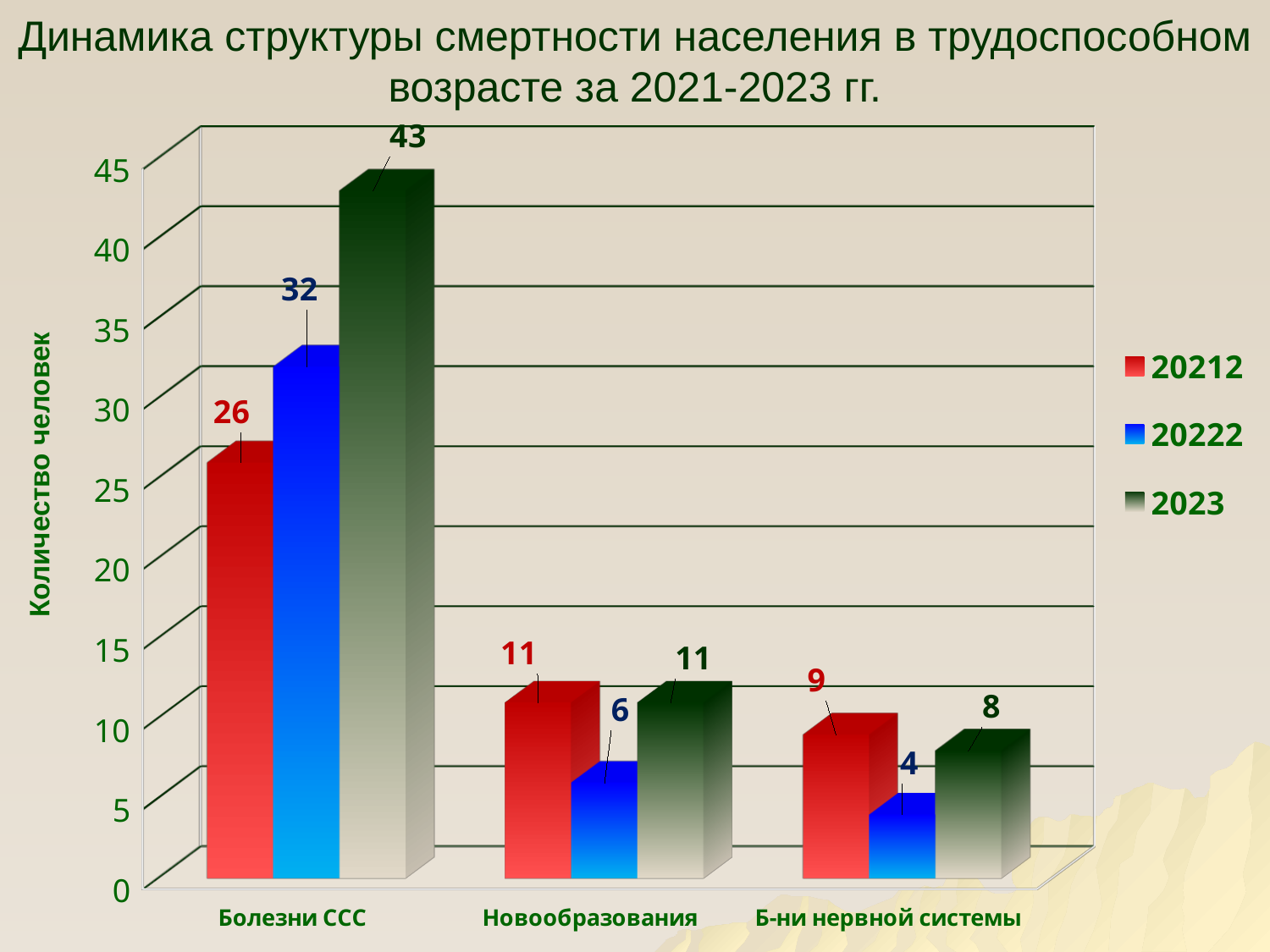
What is the value for Б-ни нервной системы in the series labelled 20212 in the legend? 9 Which category has the lowest value in the series labelled 20222? Б-ни нервной системы Which is larger for Б-ни нервной системы: the 20212 value or the 2023 value? 20212 What is the difference between the 2023 value and the 20212 value for Болезни ССС? 17 Which category has the highest value in the 2023 series? Болезни ССС What is the label of the vertical axis? Количество человек What is the total of the three series values for Новообразования? 28 What is the value for Новообразования in the series labelled 20222 in the legend? 6 What kind of chart is shown on the slide? bar chart How many series does the legend list? 3 How many categories are shown on the x axis? 3 What is the value for Болезни ССС in the 2023 series? 43